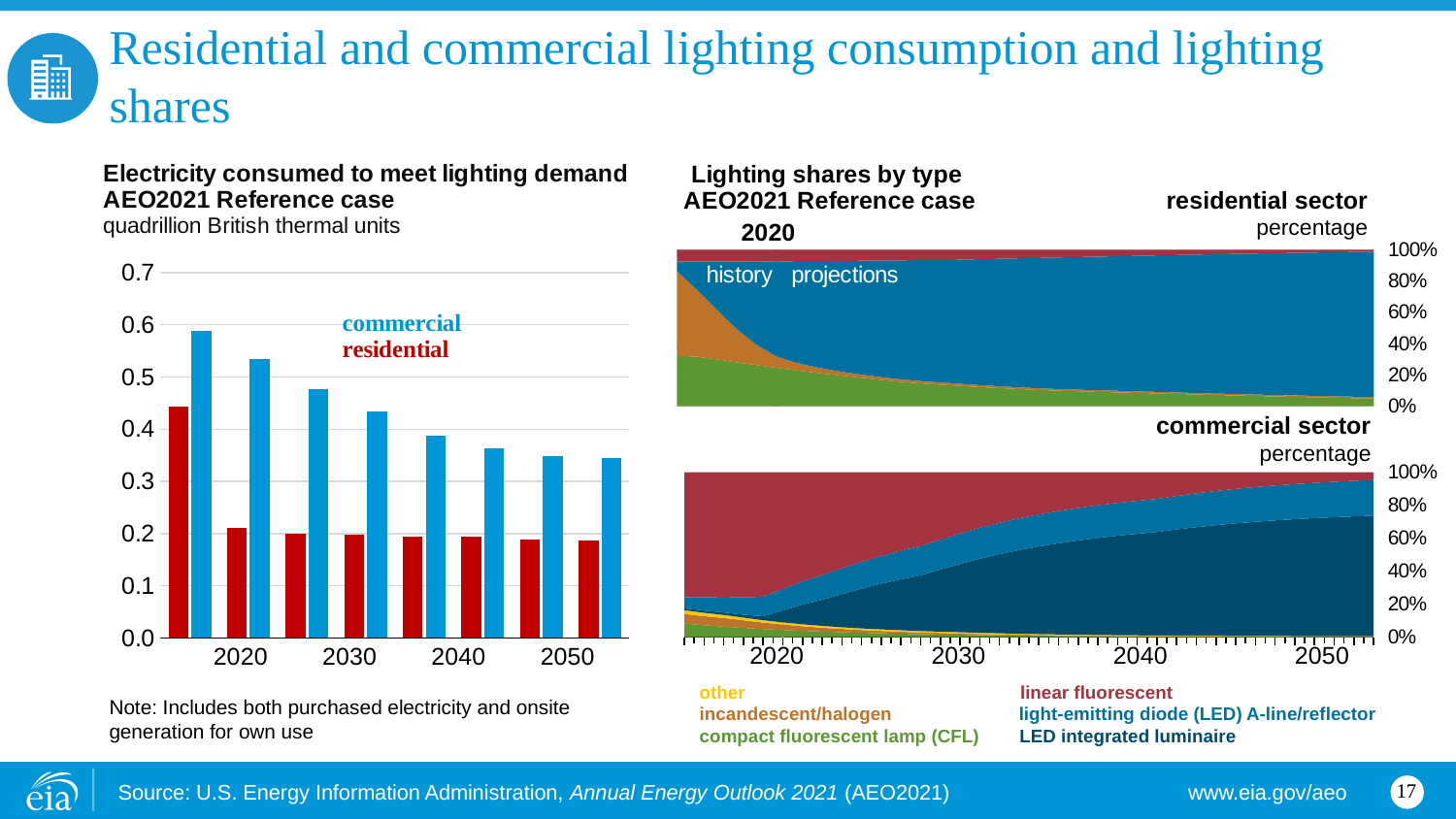
In the 'Electricity consumed to meet lighting demand' chart, is the first (leftmost) commercial bar greater or less than 0.5? greater In the 'Electricity consumed to meet lighting demand' chart, what unit is given for the values? quadrillion British thermal units In the 'Electricity consumed to meet lighting demand' chart, do the commercial values rise or fall from left to right along the x axis? fall In the 'Electricity consumed to meet lighting demand' chart, is the last (rightmost) commercial bar greater or less than 0.4? less In the 'Electricity consumed to meet lighting demand' chart, which series has the higher values throughout, commercial or residential? commercial How many lighting types are listed in the legend for the 'Lighting shares by type' charts? 6 In the 'Lighting shares by type' commercial sector chart, is the share of linear fluorescent in 2020 greater or less than 60%? greater What kind of chart is the 'Electricity consumed to meet lighting demand' chart on the left? bar chart In the 'Electricity consumed to meet lighting demand' chart, how many series are shown? 2